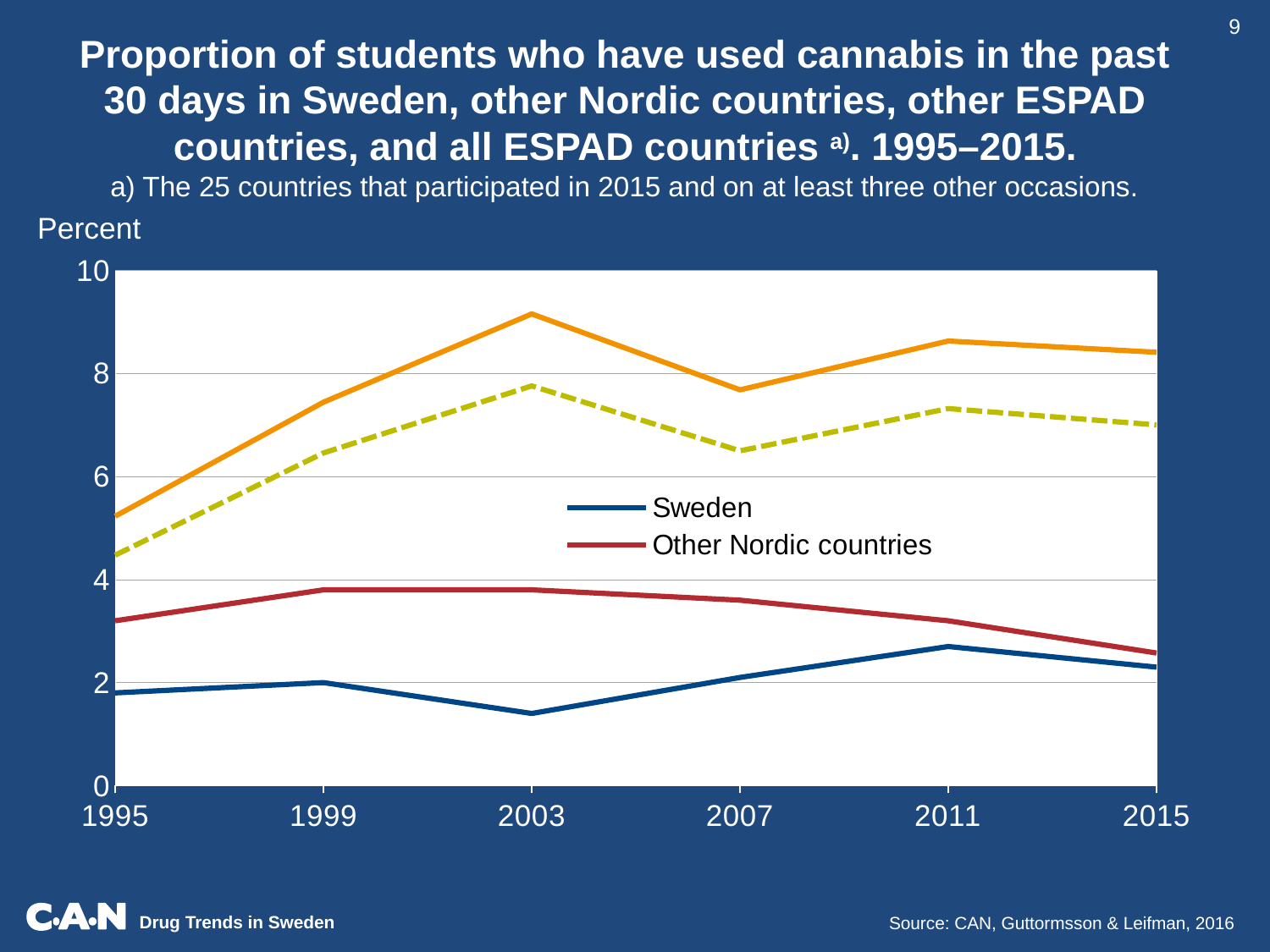
Does the value for Other Nordic countries rise or fall from 2003 to 2015? fall How many series does the legend list? 2 In which year is the value for Sweden lowest? 2003 In 2003, which is larger: the value for Sweden or for Other Nordic countries? Other Nordic countries In which year is the value for Other Nordic countries lowest? 2015 Is the value for Sweden in 2011 greater or less than 2? greater In which year is the value for Sweden highest? 2011 What kind of chart is shown on the slide? line chart Is the value for Other Nordic countries in 2015 greater or less than 2? greater How many years are marked on the x axis? 6 Is the value for Sweden in 2003 greater or less than 2? less